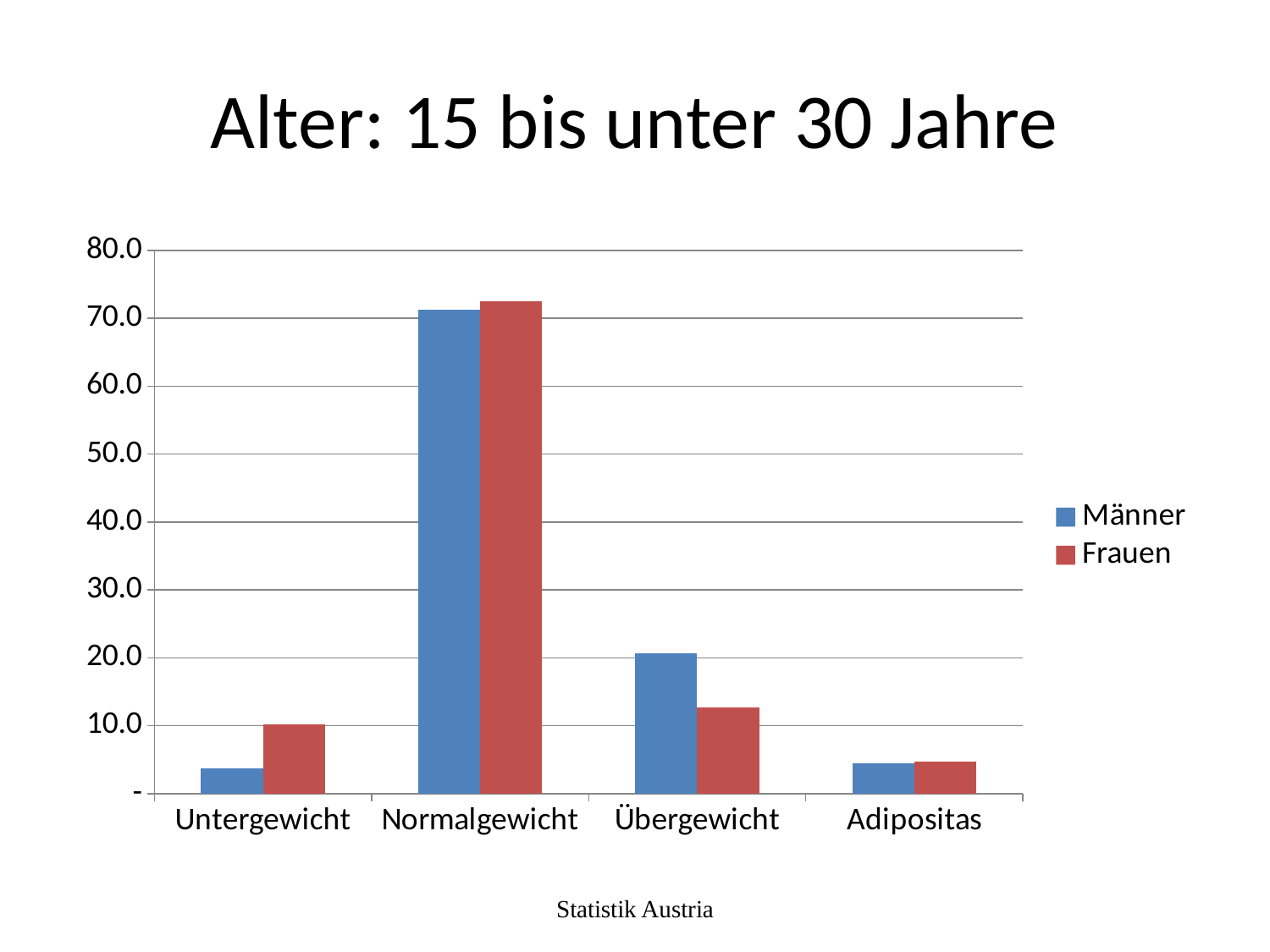
How many categories are shown on the x axis? 4 How many series does the legend list? 2 Which category has the highest value for Männer? Normalgewicht For Übergewicht, which series has the larger value, Männer or Frauen? Männer Is the value for Frauen in Übergewicht greater or less than 20.0? less For Untergewicht, which series has the larger value, Männer or Frauen? Frauen Which category has the highest value for Frauen? Normalgewicht Which category has the lowest value for Frauen? Adipositas What kind of chart is shown on the slide? bar chart Which category has the lowest value for Männer? Untergewicht Is the value for Männer in Normalgewicht greater or less than 60.0? greater What is the title of the slide? Alter: 15 bis unter 30 Jahre